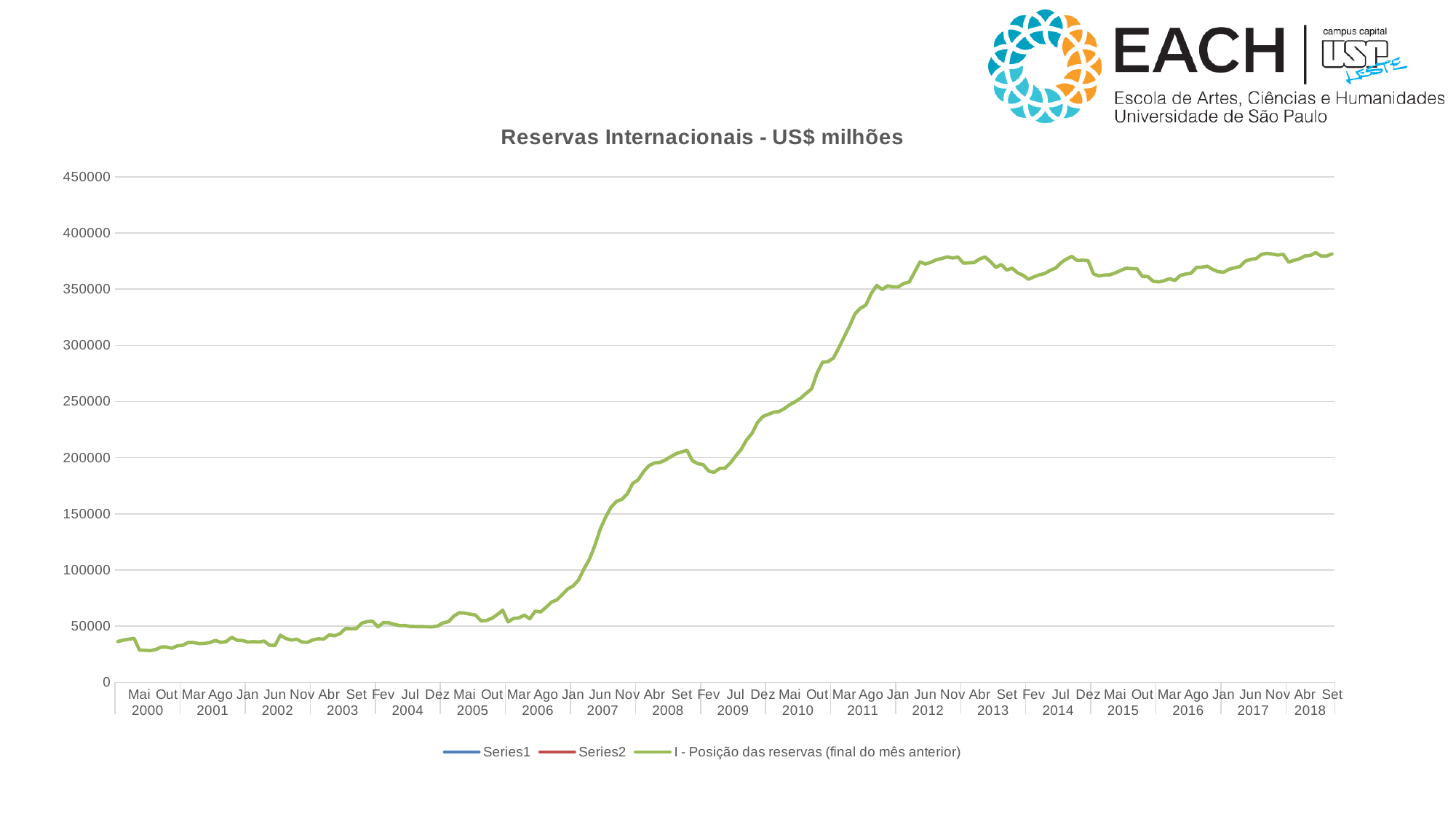
Which is larger, the value for Set 2018 or the value for Mai 2000? Set 2018 What kind of chart is shown on the slide? line chart Is the value for Dez 2009 greater or less than 200000? greater Which is larger, the value for Jul 2014 or the value for Mar 2016? Jul 2014 Is the value for Out 2010 greater or less than 250000? greater Overall, do the values rise or fall from 2000 to 2018? rise Is the value for Set 2018 greater or less than 350000? greater What is the title of the chart? Reservas Internacionais - US$ milhões What is the name of the third series in the legend? I - Posição das reservas (final do mês anterior) How many series does the legend list? 3